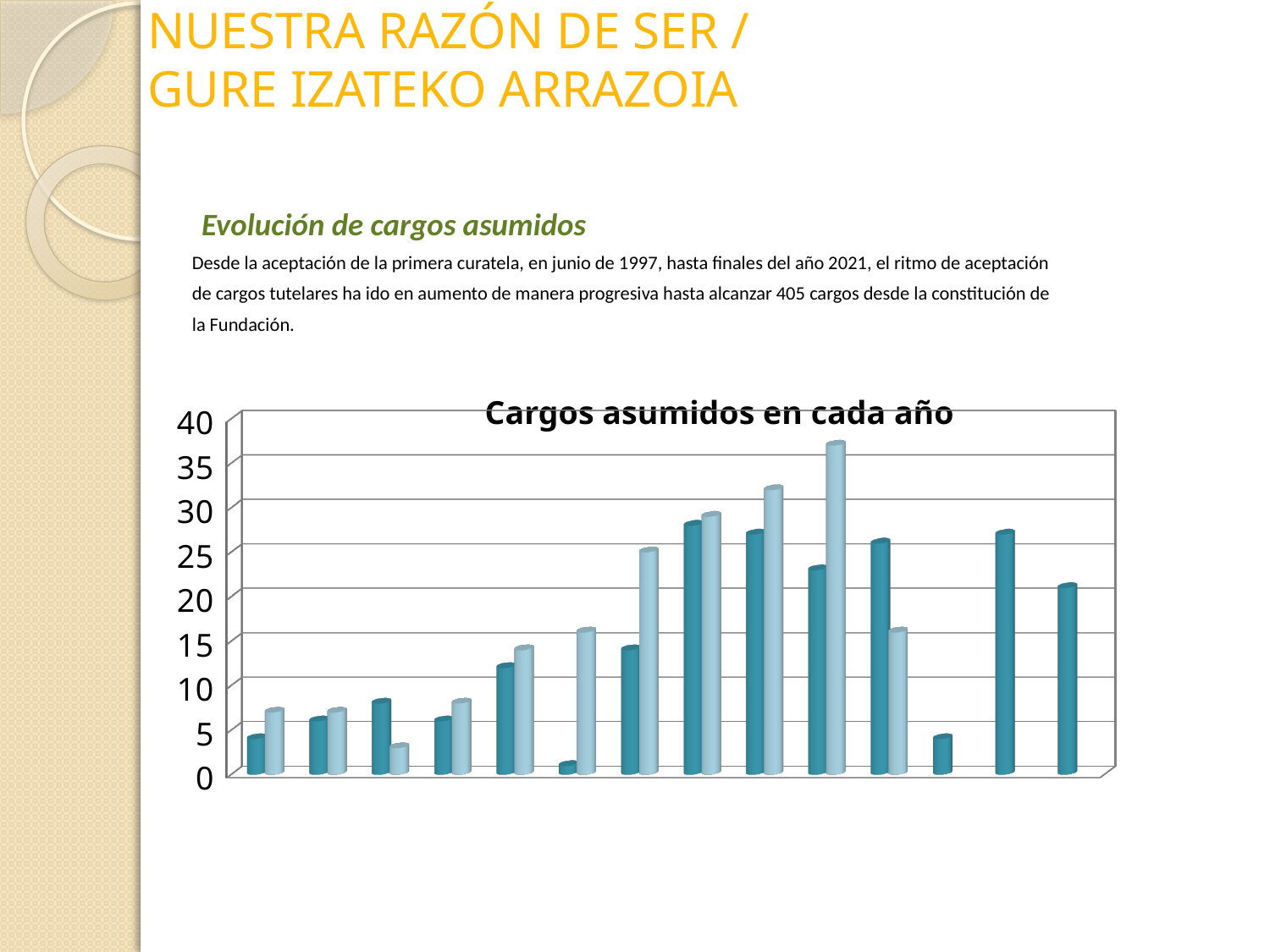
What kind of chart is shown on the slide? bar chart Is the shortest bar in the chart greater or less than 5? less Is the light blue bar in the tenth group from the left greater or less than 30? greater How many groups of bars are plotted along the x axis of the chart? 14 Is the tallest bar in the chart greater or less than 35? greater How many differently coloured bar series appear in the chart? 2 What is the title of the chart? Cargos asumidos en cada año What is the highest value shown on the chart's vertical axis? 40